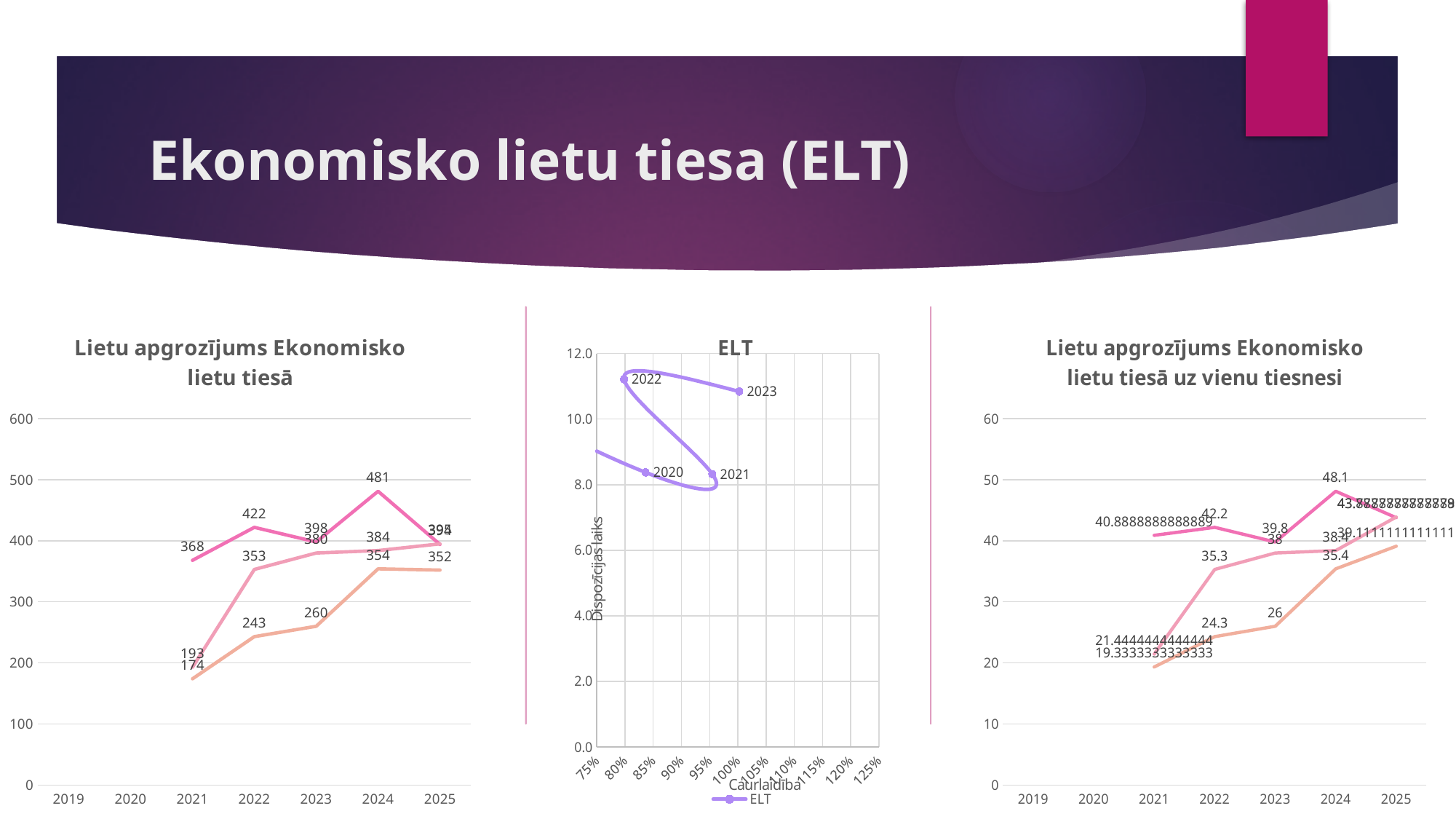
In the middle chart titled "ELT", is the Dispozīcijas laiks value for 2020 greater or less than 10.0? less In the chart titled "Lietu apgrozījums Ekonomisko lietu tiesā", what is the value of the lowest line in 2022? 243 In the chart titled "Lietu apgrozījums Ekonomisko lietu tiesā", what is the lowest labelled value? 174 How many series does the legend of the middle chart titled "ELT" list? 1 In the middle chart titled "ELT", what is the title of the x axis? Caurlaidība How many years are shown on the x axis of the chart titled "Lietu apgrozījums Ekonomisko lietu tiesā"? 7 In the chart titled "Lietu apgrozījums Ekonomisko lietu tiesā uz vienu tiesnesi", what is the value of the lowest line in 2023? 26 What kind of chart is the left chart, "Lietu apgrozījums Ekonomisko lietu tiesā"? line chart In the chart titled "Lietu apgrozījums Ekonomisko lietu tiesā", what is the highest labelled value? 481 In the chart titled "Lietu apgrozījums Ekonomisko lietu tiesā", what is the difference between the top line (481) and the bottom line (354) in 2024? 127 In the chart titled "Lietu apgrozījums Ekonomisko lietu tiesā uz vienu tiesnesi", what is the highest labelled value? 48.1 In the middle chart titled "ELT", is the Dispozīcijas laiks value for 2022 greater or less than 10.0? greater